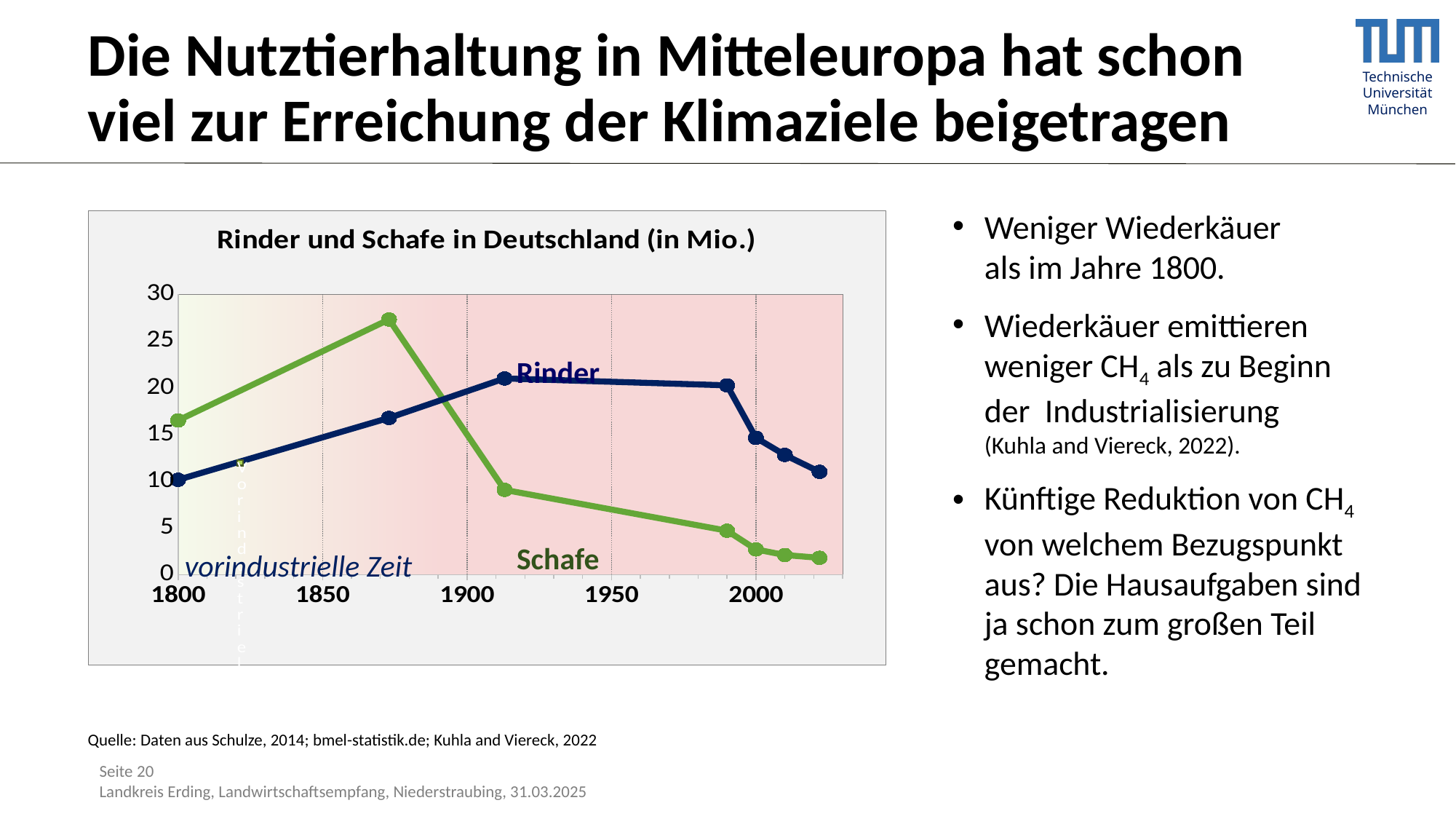
Is the value for Rinder around 1913 greater or less than 20? greater Is the value for Schafe in 1800 greater or less than 15? greater What kind of chart is shown on the slide? line chart Is the value for Schafe around 1913 greater or less than 10? less Do the Rinder values rise or fall from 1990 to the end of the series? fall In 1800, which series has the higher value, Rinder or Schafe? Schafe Which series is drawn in green? Schafe What is the title of the chart? Rinder und Schafe in Deutschland (in Mio.) Around 1950, which series has the higher value, Rinder or Schafe? Rinder How many series are plotted in the chart? 2